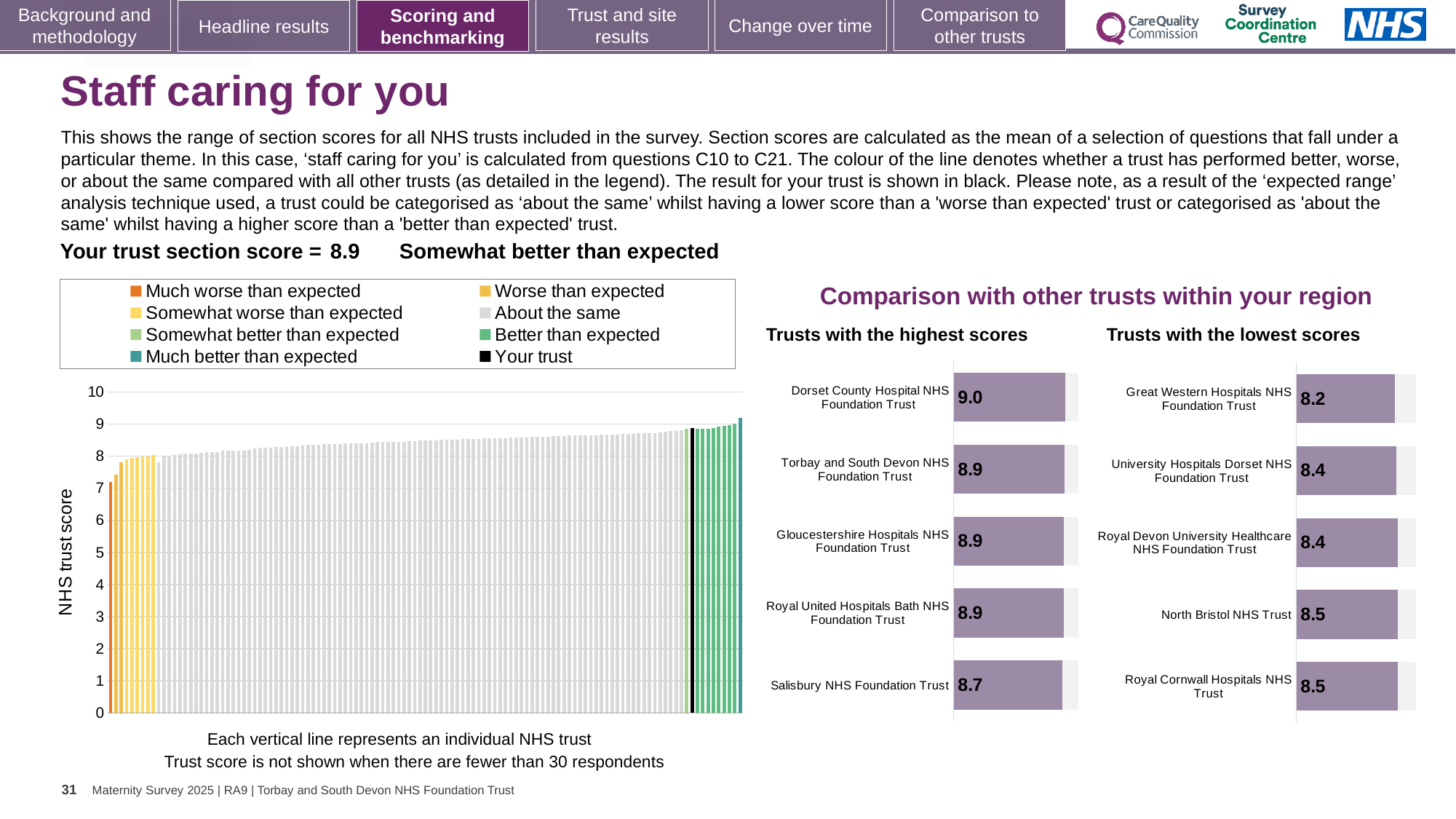
In the large chart on the left, do the bar values rise or fall from left to right? Rise In the 'Trusts with the lowest scores' chart, which has the larger score: North Bristol NHS Trust or University Hospitals Dorset NHS Foundation Trust? North Bristol NHS Trust How many entries does the legend of the large chart on the left list? 8 What is the y-axis label of the large chart on the left? NHS trust score In the 'Trusts with the lowest scores' chart, which trust has the lowest score? Great Western Hospitals NHS Foundation Trust In the 'Trusts with the highest scores' chart, what is the difference between the scores of Dorset County Hospital NHS Foundation Trust and Salisbury NHS Foundation Trust? 0.3 In the 'Trusts with the lowest scores' chart, what is the score for Royal Cornwall Hospitals NHS Trust? 8.5 In the 'Trusts with the highest scores' chart, what is the score for Dorset County Hospital NHS Foundation Trust? 9.0 How many trusts are shown in the 'Trusts with the highest scores' chart? 5 What kind of chart is the large chart on the left showing NHS trust scores? Bar chart In the 'Trusts with the lowest scores' chart, what is the score for Great Western Hospitals NHS Foundation Trust? 8.2 In the 'Trusts with the highest scores' chart, which trust has the lowest score? Salisbury NHS Foundation Trust